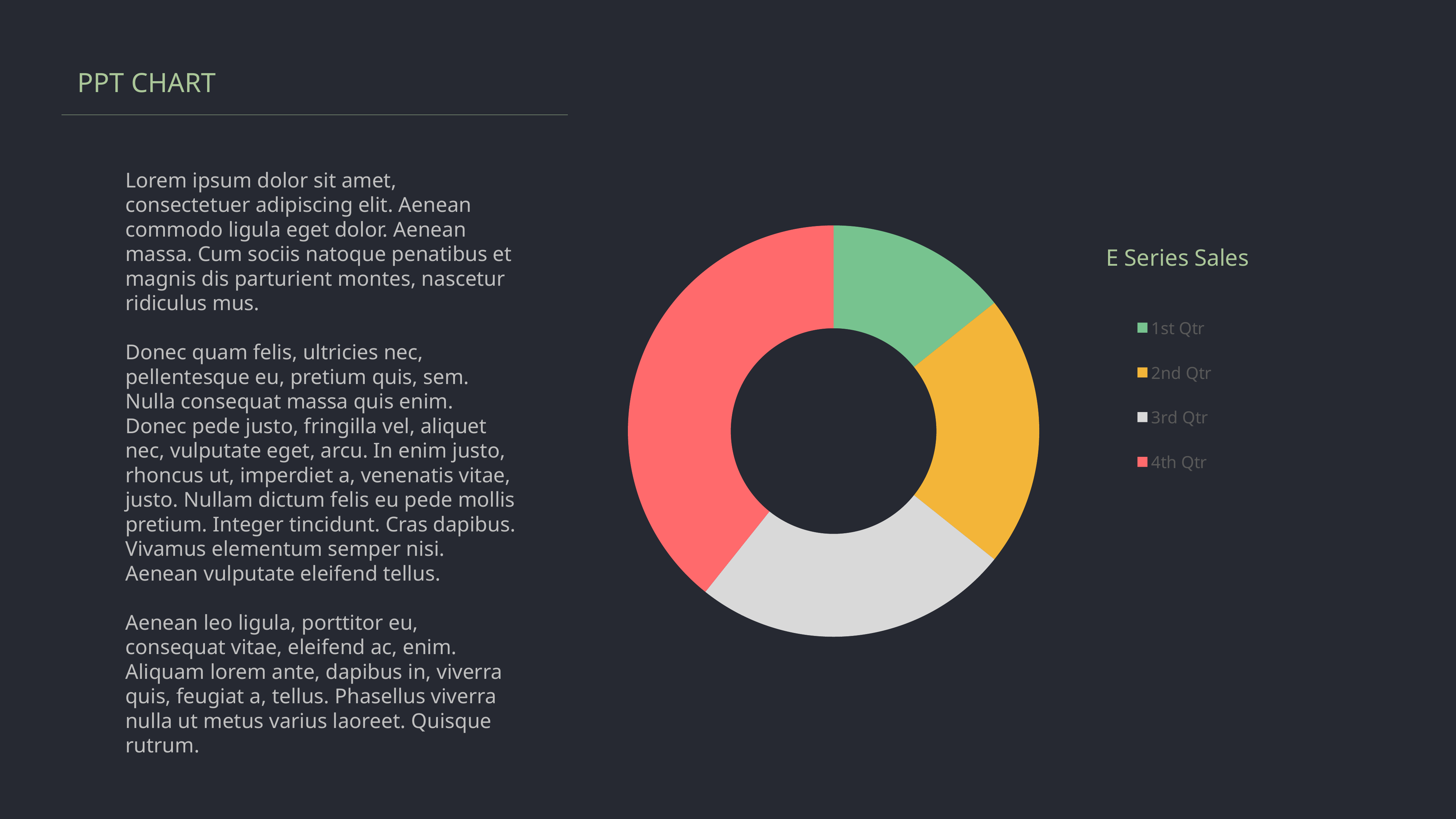
Which category has the smallest slice in the chart? 1st Qtr How many categories does the chart show? 4 What colour is the 4th Qtr slice in the chart? Red What type of chart is shown on the slide? Doughnut (pie) chart Which is larger, the slice for 3rd Qtr or the slice for 4th Qtr? 4th Qtr Which category has the largest slice in the chart? 4th Qtr Which is larger, the slice for 4th Qtr or the slice for 2nd Qtr? 4th Qtr Which is larger, the slice for 4th Qtr or the slice for 1st Qtr? 4th Qtr What are the legend entries listed for the chart? 1st Qtr, 2nd Qtr, 3rd Qtr, 4th Qtr What is the title of the chart? E Series Sales